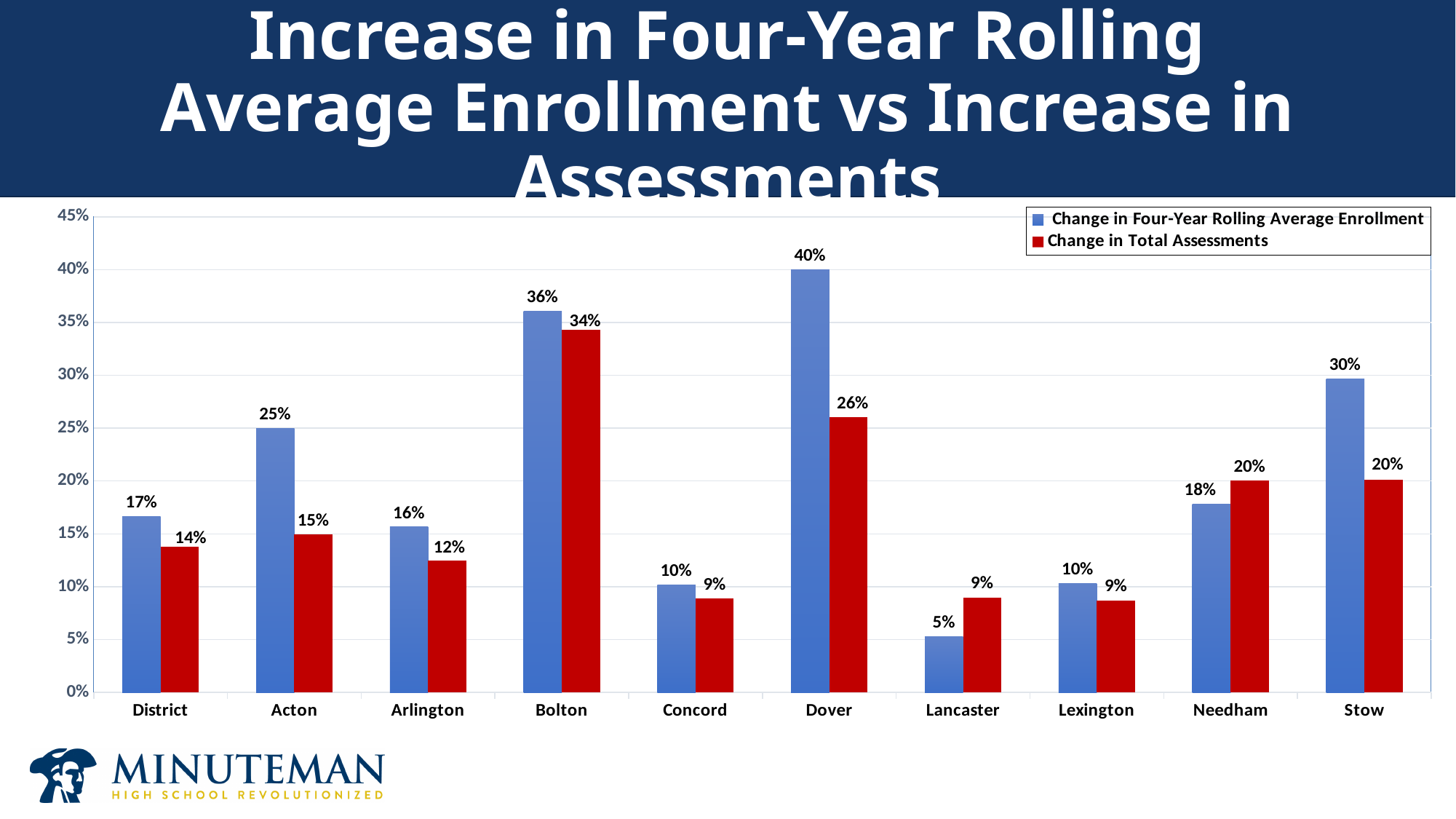
Which category has the highest Change in Four-Year Rolling Average Enrollment? Dover What colour are the bars for Change in Total Assessments? Red Is the Change in Four-Year Rolling Average Enrollment for Stow greater or less than 25%? greater What is the Change in Total Assessments for Bolton? 34% How many categories are shown on the x axis? 10 What is the Change in Total Assessments for Needham? 20% What kind of chart is shown on the slide? Bar chart What is the Change in Four-Year Rolling Average Enrollment for Dover? 40% What is the difference between the Change in Four-Year Rolling Average Enrollment and the Change in Total Assessments for Dover? 14% For Acton, which is larger: the Change in Four-Year Rolling Average Enrollment or the Change in Total Assessments? Change in Four-Year Rolling Average Enrollment How many series does the legend list? 2 Which category has the lowest Change in Four-Year Rolling Average Enrollment? Lancaster